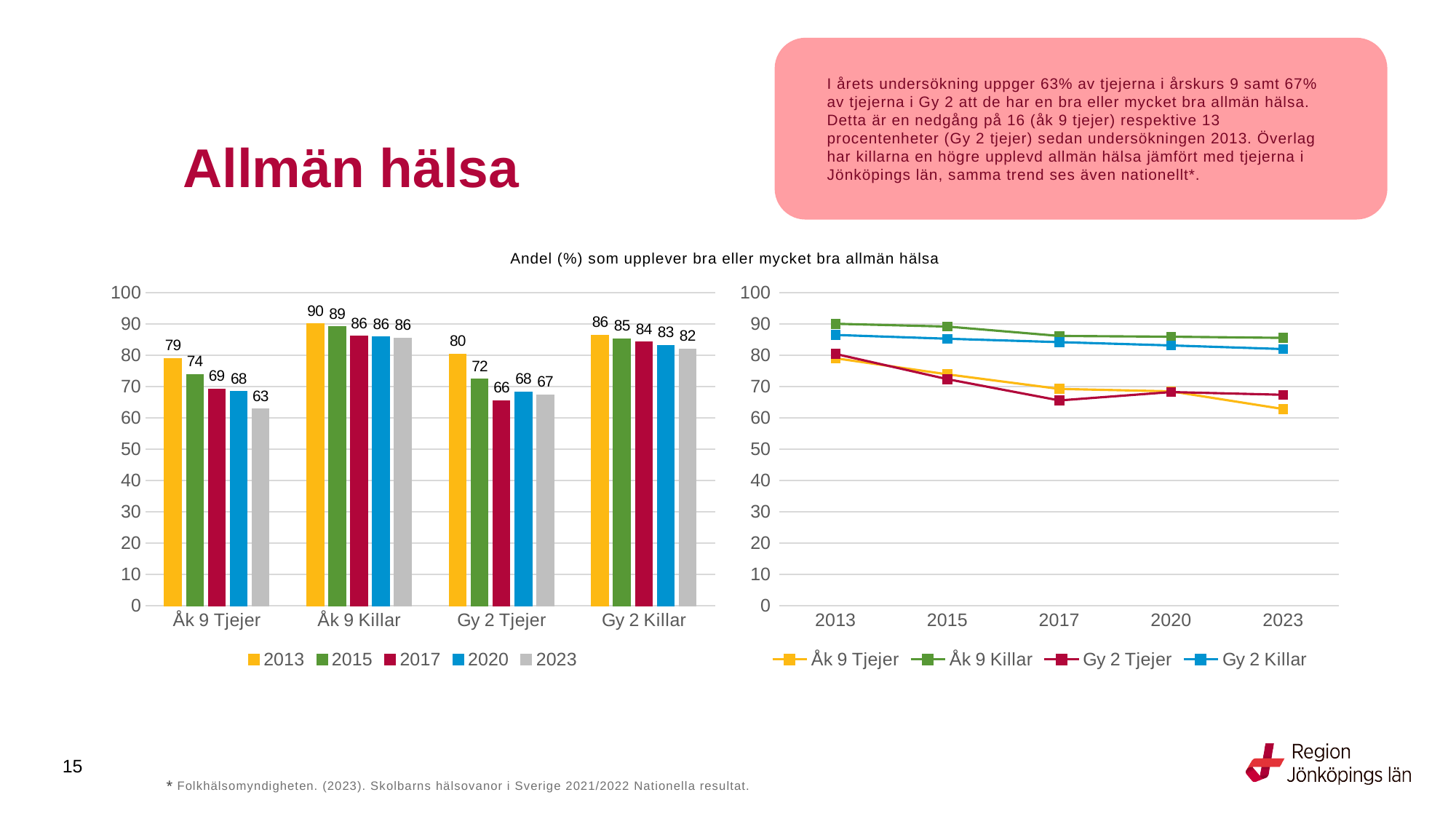
How many series does the legend of the bar chart on the left list? 5 In the line chart on the right, is the value for Gy 2 Tjejer in 2017 greater or less than 70? less In the bar chart on the left, what is the value for Åk 9 Tjejer in 2023? 63 In the bar chart on the left, what is the value for Gy 2 Killar in 2013? 86 In the bar chart on the left, which is larger: the 2017 value for Åk 9 Killar or the 2017 value for Gy 2 Killar? Åk 9 Killar What kind of chart is shown on the right side of the slide? Line chart In the line chart on the right, does the Åk 9 Tjejer series rise or fall from 2013 to 2023? Fall How many series does the legend of the line chart on the right list? 4 In the bar chart on the left, what is the difference between the 2013 and 2023 values for Gy 2 Tjejer? 13 How many categories are shown on the x axis of the bar chart on the left? 4 In the bar chart on the left, which category has the lowest 2023 value? Åk 9 Tjejer In the bar chart on the left, which category has the highest 2013 value? Åk 9 Killar